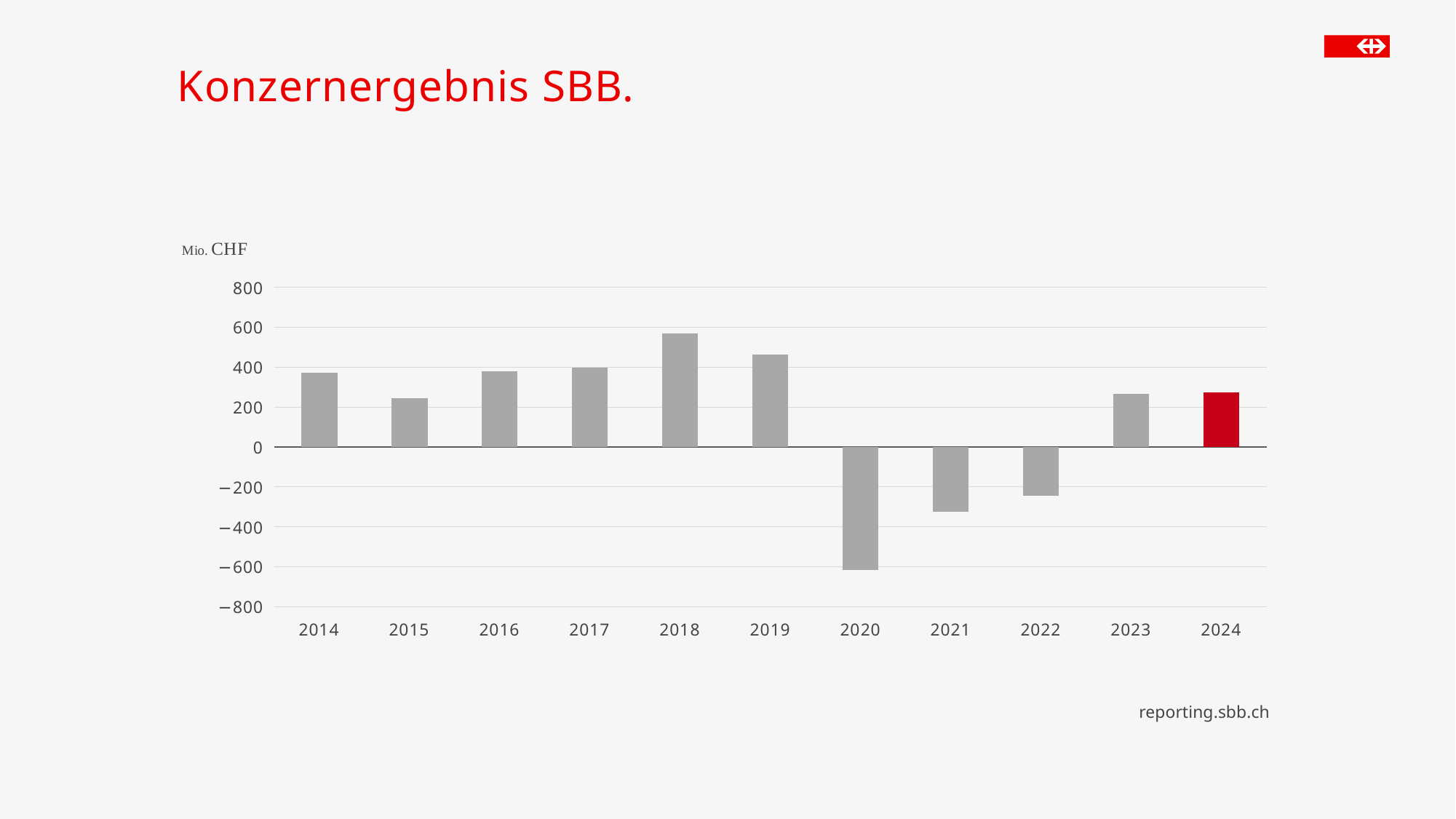
Which year has the larger value, 2018 or 2019? 2018 What is the title of the chart? Konzernergebnis SBB. Do the values rise or fall from 2020 to 2024? rise Which year has the lowest value in the chart? 2020 How many years are shown on the x axis of the chart? 11 Is the value for 2020 greater or less than -400? less Is the value for 2018 greater or less than 400? greater Is the value for 2021 greater or less than -200? less What type of chart is shown on the slide? bar chart What unit is shown on the y axis of the chart? Mio. CHF Which year has the highest value in the chart? 2018